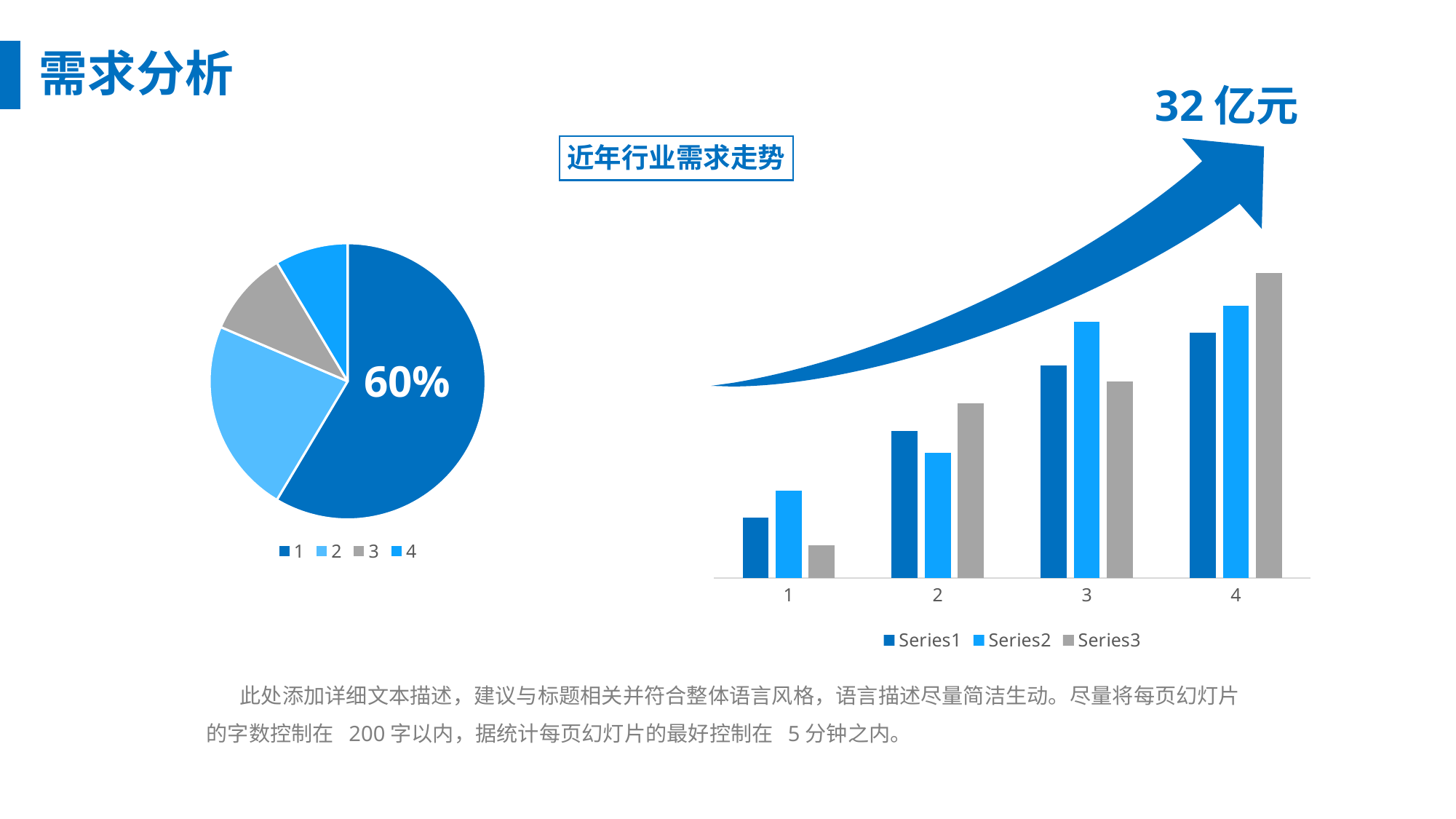
How many slices does the pie chart on the left have? 4 In the pie chart on the left, which slice is larger, slice 2 or slice 3? 2 How many categories are shown on the x axis of the bar chart on the right? 4 How many series does the legend of the bar chart on the right list? 3 In the bar chart on the right, do the Series1 values rise or fall from category 1 to category 4? rise In the pie chart on the left, which slice is the largest? 1 What kind of chart is the chart on the left of the slide? pie chart In the pie chart on the left, what share of the pie does slice 1 have? 60% In the bar chart on the right, which category has the highest Series3 value? 4 In the bar chart on the right, which category has the lowest Series1 value? 1 What is the title shown above the bar chart on the right? 近年行业需求走势 What kind of chart is the chart on the right of the slide? bar chart